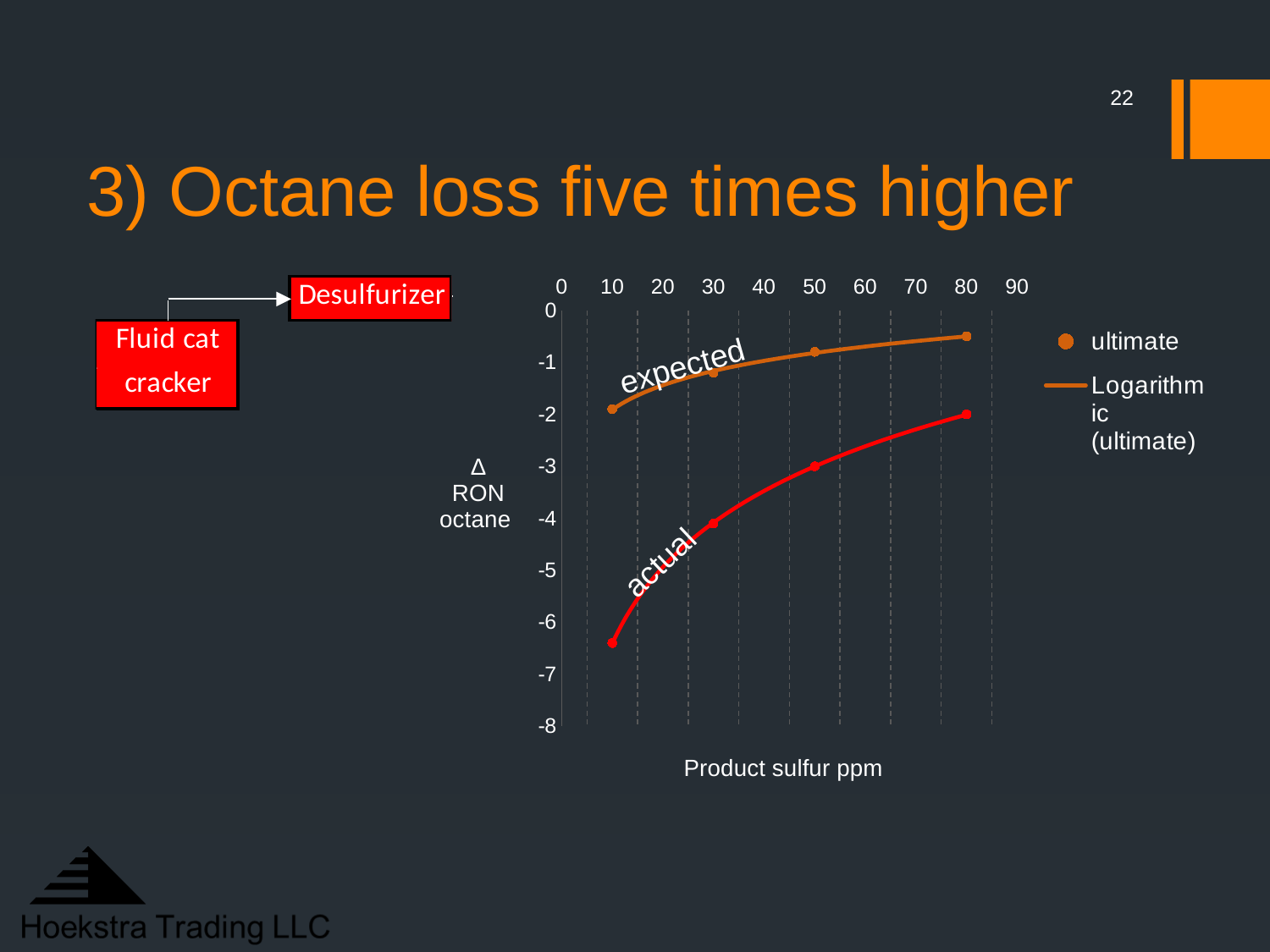
Which curve lies above the other across the whole chart, 'expected' or 'actual'? expected Is the 'actual' value at 10 ppm product sulfur greater or less than -6? less Do the Δ RON octane values on the 'actual' curve rise or fall as product sulfur increases from 10 to 80 ppm? rise How many entries does the chart legend list? 2 What is the label of the x axis of the chart? Product sulfur ppm How many data points are plotted on the 'actual' curve? 4 At 10 ppm product sulfur, which curve shows the larger octane loss, 'expected' or 'actual'? actual Is the 'expected' value at 30 ppm product sulfur greater or less than -2? greater What kind of chart is shown on the slide? Scatter chart with curves (line chart) What are the two entries in the chart legend? ultimate; Logarithmic (ultimate) Is the 'expected' value at 80 ppm product sulfur greater or less than -1? greater How many data points are plotted on the 'expected' curve? 4